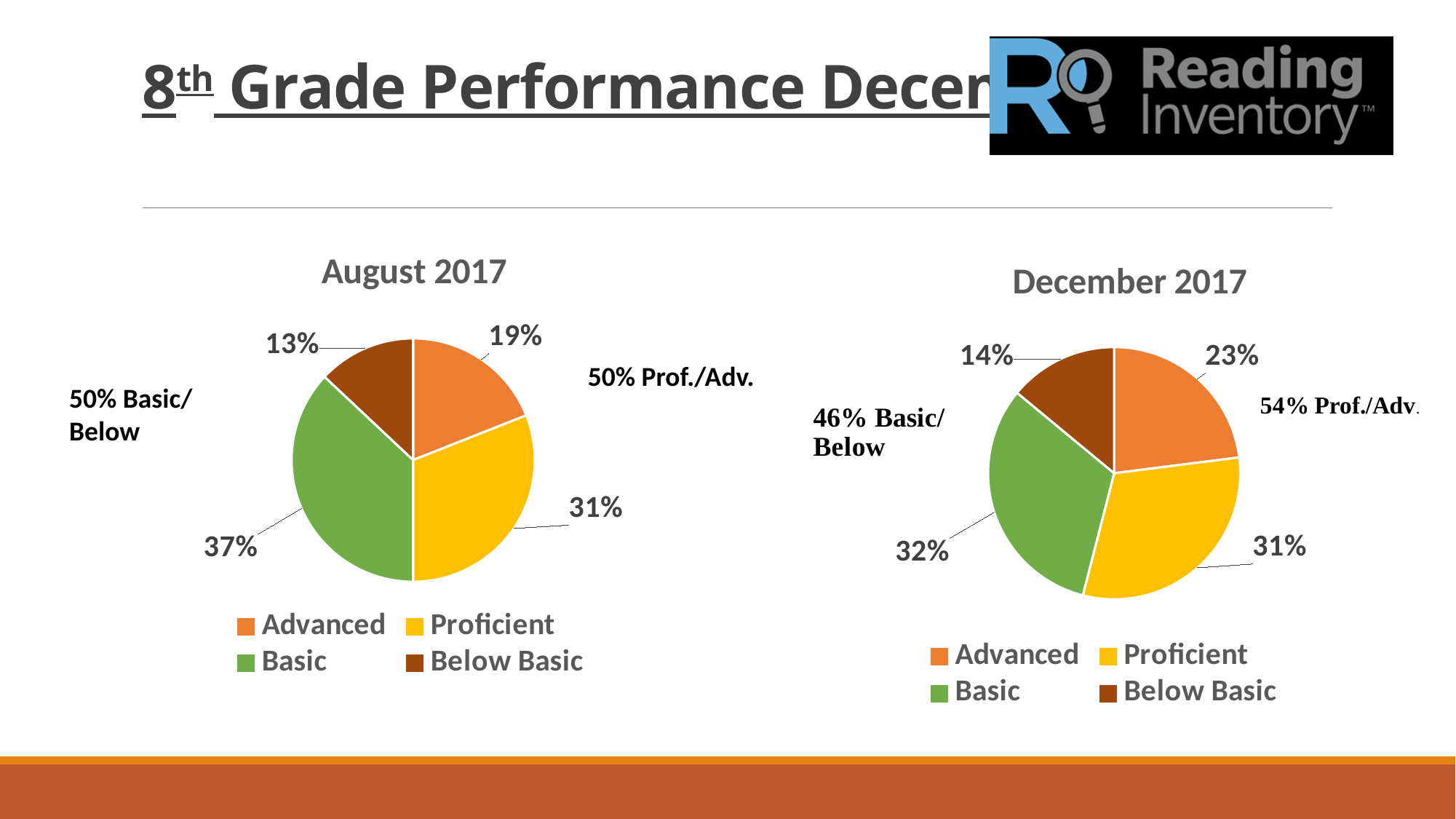
How many entries does the legend of the December 2017 chart list? 4 What kind of chart is the August 2017 chart? Pie chart In the August 2017 chart, what is the combined share of Advanced and Proficient? 50% In the December 2017 chart, what is the difference between the Proficient and Advanced percentages? 8% How many categories does the December 2017 chart show? 4 In the August 2017 chart, which category has the largest share? Basic In the December 2017 chart, what is the combined share of Basic and Below Basic? 46% In the August 2017 chart, what percentage of students are Advanced? 19% In the August 2017 chart, which is larger, the Proficient share or the Below Basic share? Proficient In the August 2017 chart, what colour is the Basic slice? Green In the December 2017 chart, which category has the smallest share? Below Basic In the December 2017 chart, what percentage of students are Basic? 32%